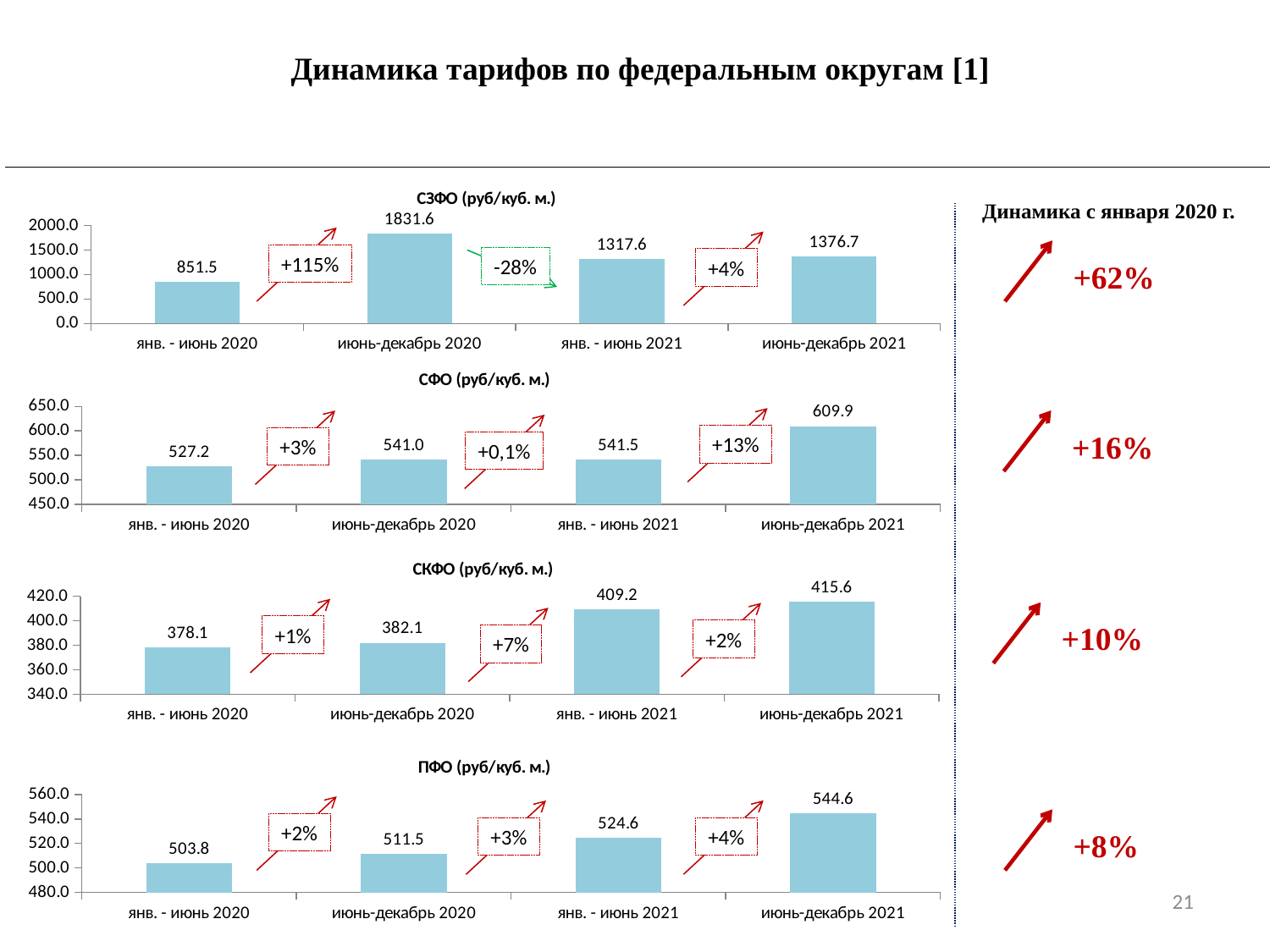
How many bars are plotted in the ПФО (руб/куб. м.) chart? 4 What is the title of the slide? Динамика тарифов по федеральным округам [1] In the СФО (руб/куб. м.) chart, which period has the lowest value? янв. - июнь 2020 In the СЗФО (руб/куб. м.) chart, what is the difference between the values for июнь-декабрь 2020 and янв. - июнь 2021? 514.0 In the ПФО (руб/куб. м.) chart, what is the value for июнь-декабрь 2021? 544.6 In the СЗФО (руб/куб. м.) chart, what is the value for июнь-декабрь 2020? 1831.6 In the СКФО (руб/куб. м.) chart, do the values rise or fall from янв. - июнь 2020 to июнь-декабрь 2021? rise In the СЗФО (руб/куб. м.) chart, which period has the highest value? июнь-декабрь 2020 In the ПФО (руб/куб. м.) chart, which is larger: the value for июнь-декабрь 2020 or the value for янв. - июнь 2021? янв. - июнь 2021 In the СКФО (руб/куб. м.) chart, what is the difference between the values for июнь-декабрь 2021 and янв. - июнь 2020? 37.5 What kind of chart is the СФО (руб/куб. м.) chart? bar chart In the СФО (руб/куб. м.) chart, what is the value for янв. - июнь 2021? 541.5